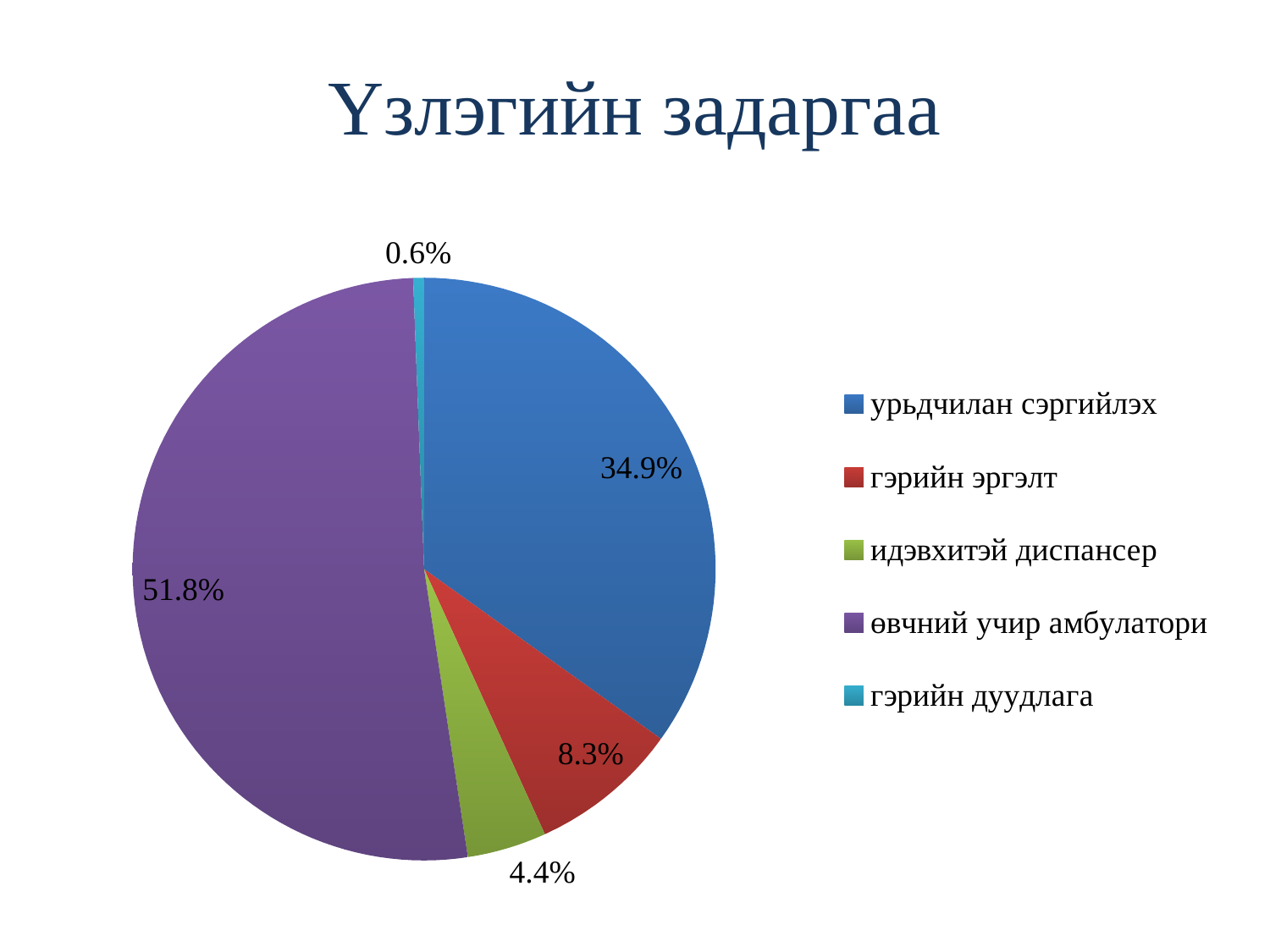
What is the share for гэрийн дуудлага? 0.6% What is the difference in percentage points between өвчний учир амбулатори and урьдчилан сэргийлэх? 16.9 What kind of chart is shown on the slide? pie chart Which is larger, the share for гэрийн эргэлт or the share for идэвхитэй диспансер? гэрийн эргэлт Which category has the largest share of the pie? өвчний учир амбулатори Which category has the smallest share of the pie? гэрийн дуудлага What is the share for идэвхитэй диспансер? 4.4% What is the share for гэрийн эргэлт? 8.3% What is the title of the chart slide? Үзлэгийн задаргаа What is the share for урьдчилан сэргийлэх? 34.9% What is the share for өвчний учир амбулатори? 51.8% How many categories does the legend list? 5